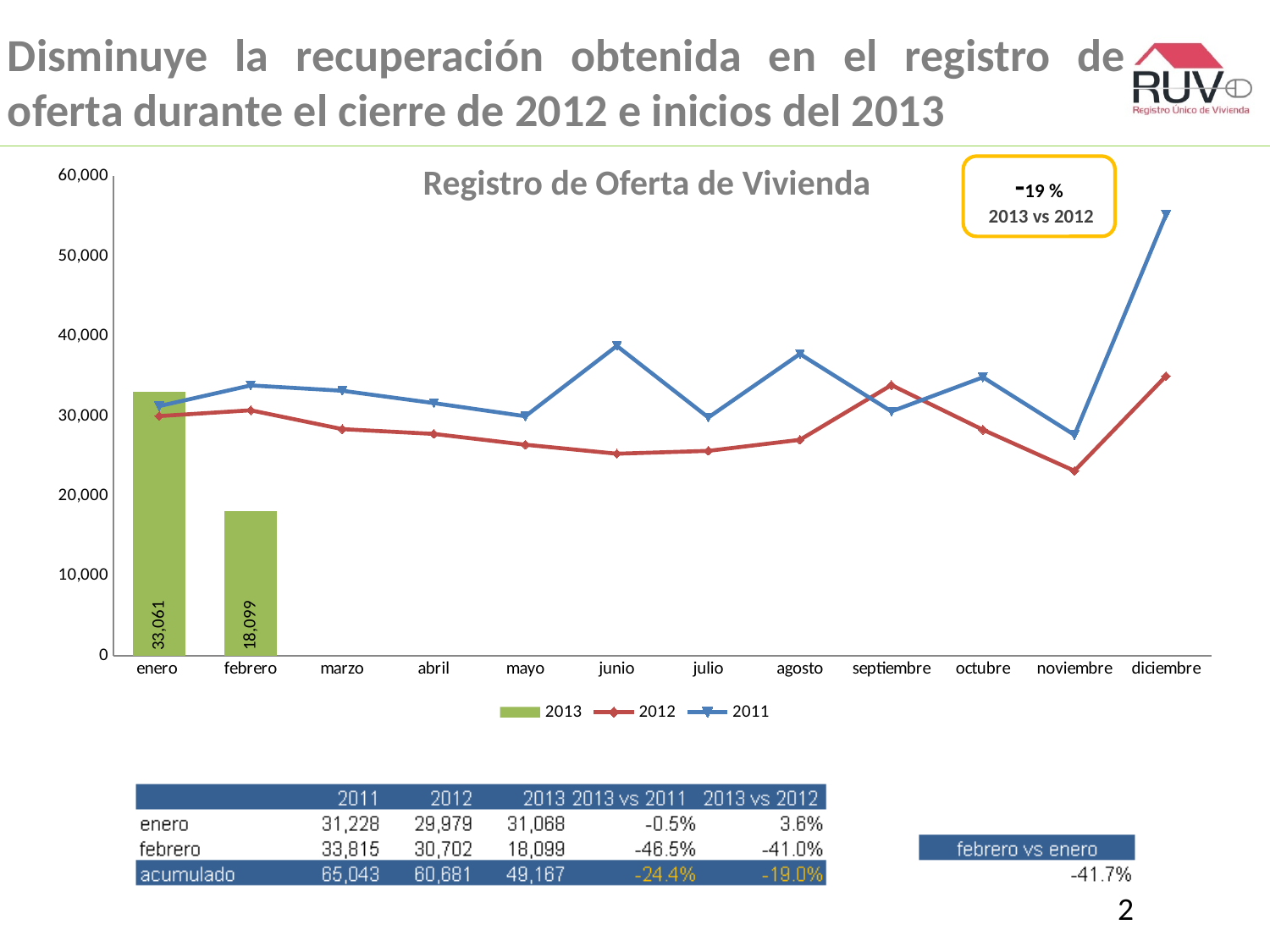
How many months are shown on the x axis? 12 Which month has the larger 2013 value, enero or febrero? enero How many series does the legend list? 3 Is the 2011 value for diciembre greater or less than 50,000? greater Is the 2012 value for noviembre greater or less than 30,000? less What is the title of the chart? Registro de Oferta de Vivienda What is the value of the 2013 bar for febrero? 18,099 What kind of chart is this? bar and line chart In junio, which series has the higher value, 2011 or 2012? 2011 What is the difference between the 2013 values for enero and febrero? 14,962 What is the value of the 2013 bar for enero? 33,061 In which month does the 2011 series reach its highest value? diciembre